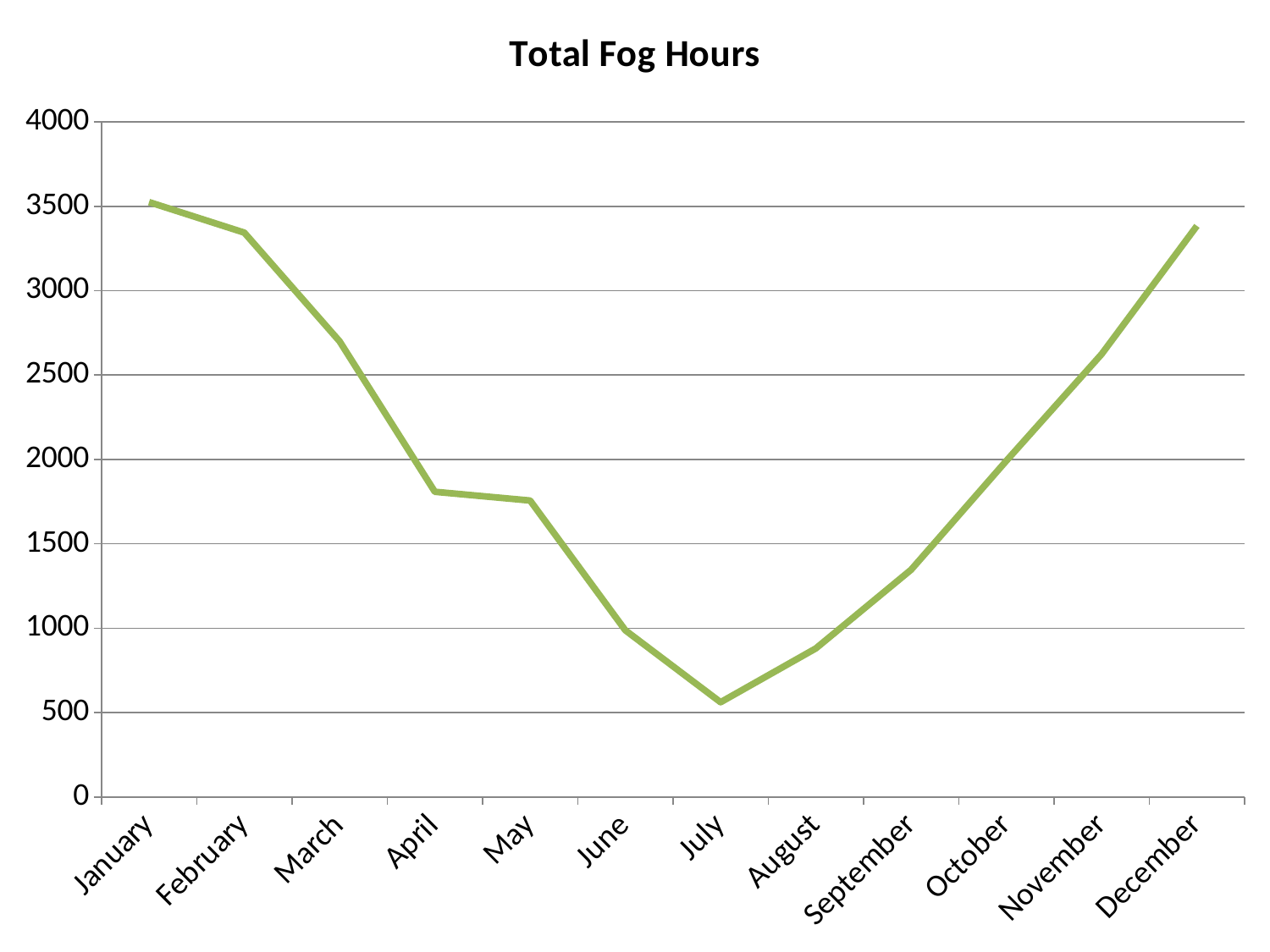
Which has more total fog hours, May or September? May Is the value for February greater or less than 3500? less What kind of chart is shown on the slide? line chart Is the value for March greater or less than 2500? greater Do the total fog hours rise or fall from January to July? fall Is the value for November greater or less than 2500? greater What is the title of the chart? Total Fog Hours Which month has the highest total fog hours? January How many months are plotted along the x axis? 12 Which month has the lowest total fog hours? July